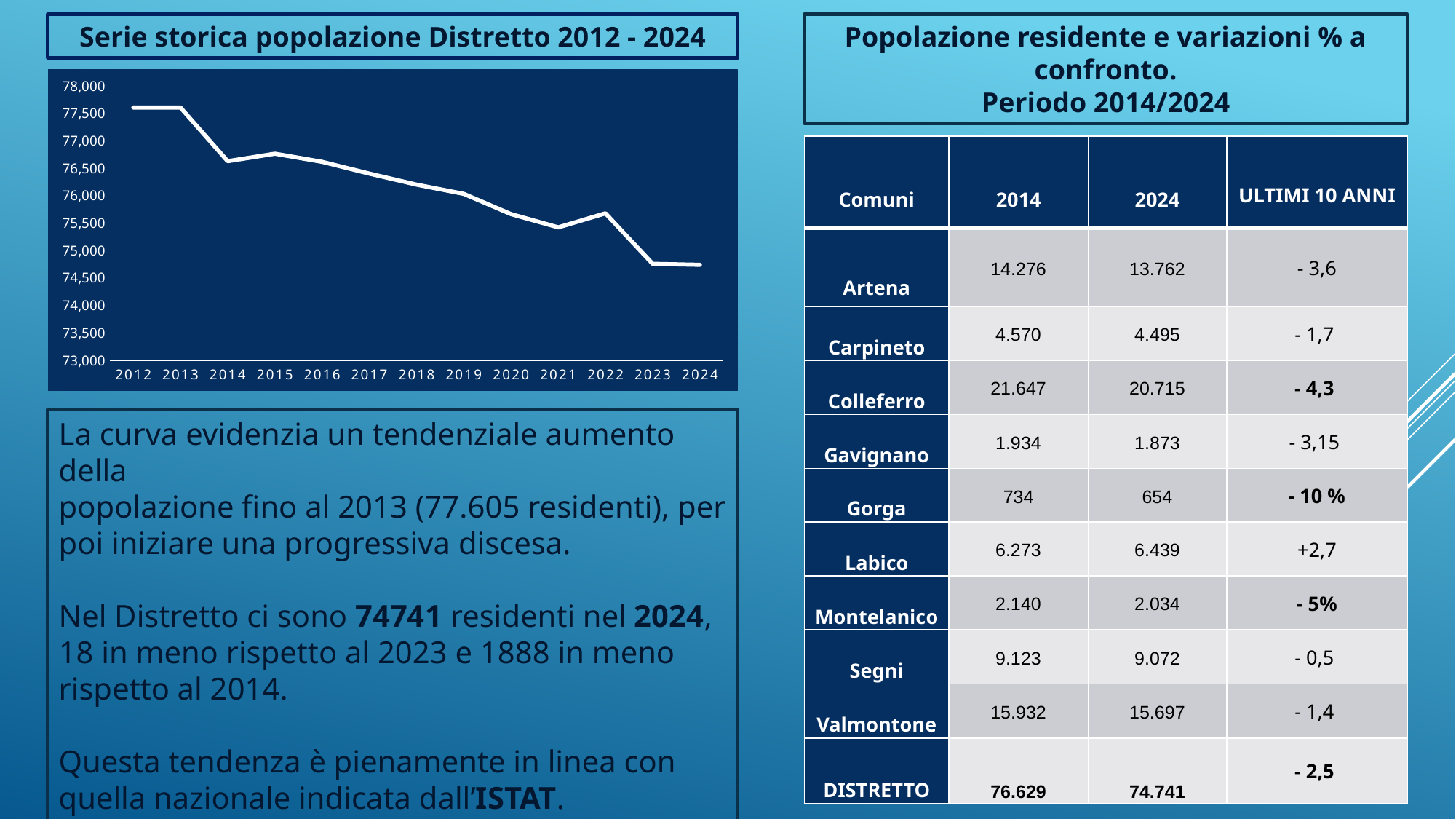
What kind of chart is shown on the slide? line chart Is the value for 2024 greater or less than 75,000? less How many years are plotted on the x axis of the chart? 13 Is the value for 2020 greater or less than 76,000? less Overall, does the population line rise or fall from 2012 to 2024? fall What is the lowest value shown on the y axis of the chart? 73,000 Which year has the higher value, 2012 or 2024? 2012 Which year has the higher value, 2021 or 2022? 2022 Is the value for 2019 greater or less than 76,500? less What is the title of the chart on the slide? Serie storica popolazione Distretto 2012 - 2024